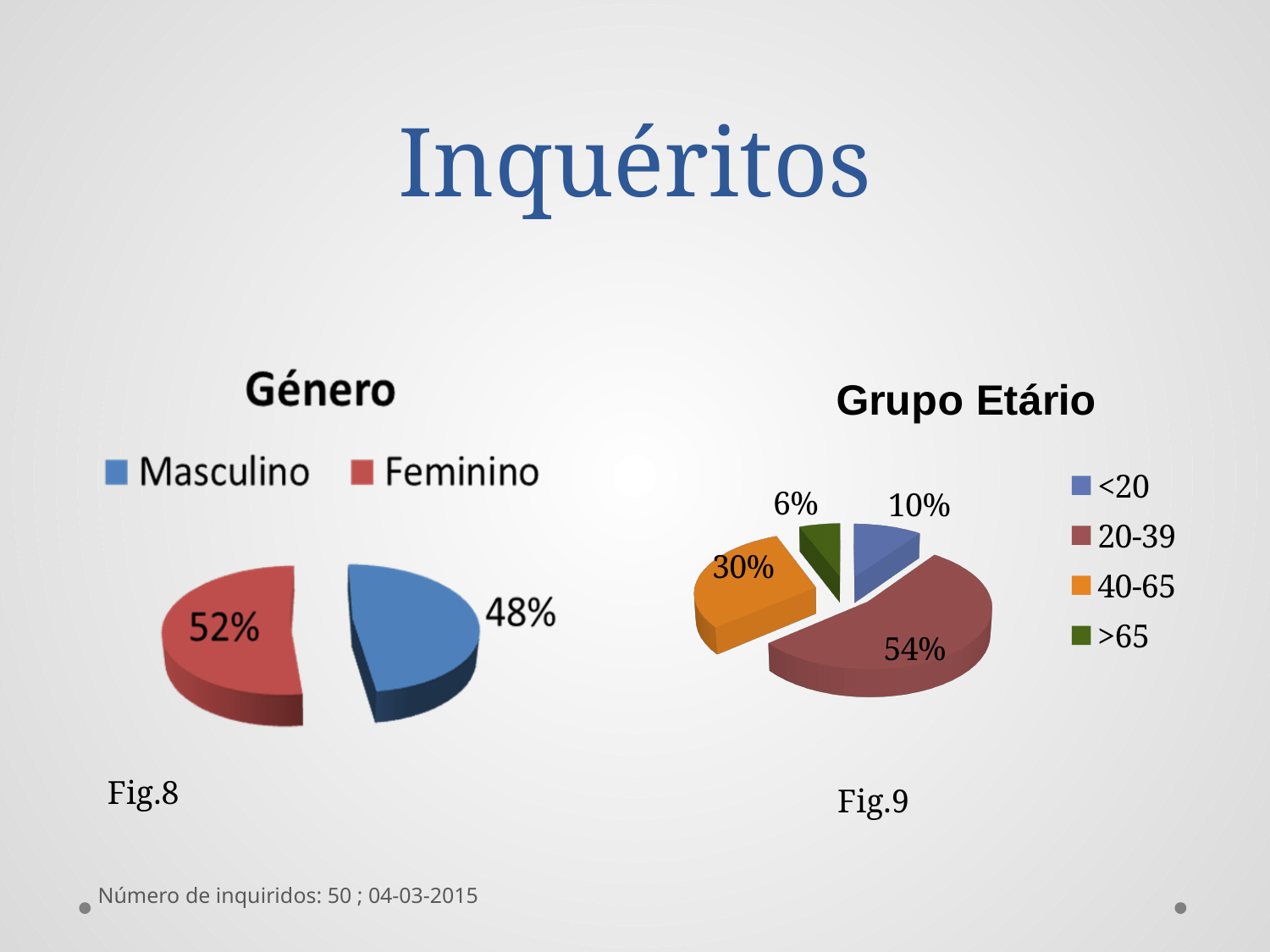
What kind of chart is the 'Género' chart? Pie chart In the 'Grupo Etário' chart, how many age groups are shown? 4 In the 'Género' chart, what percentage is Masculino? 48% In the 'Grupo Etário' chart, what is the difference between the 20-39 and 40-65 shares? 24% In the 'Grupo Etário' chart, what percentage is the 20-39 group? 54% In the 'Género' chart, which category has the larger share? Feminino In the 'Grupo Etário' chart, which age group has the largest share? 20-39 In the 'Género' chart, what is the difference between the Feminino and Masculino shares? 4% In the 'Grupo Etário' chart, what percentage is the 40-65 group? 30% In the 'Género' chart, what percentage is Feminino? 52% In the 'Grupo Etário' chart, which is larger: the <20 group or the >65 group? <20 In the 'Grupo Etário' chart, which age group has the smallest share? >65